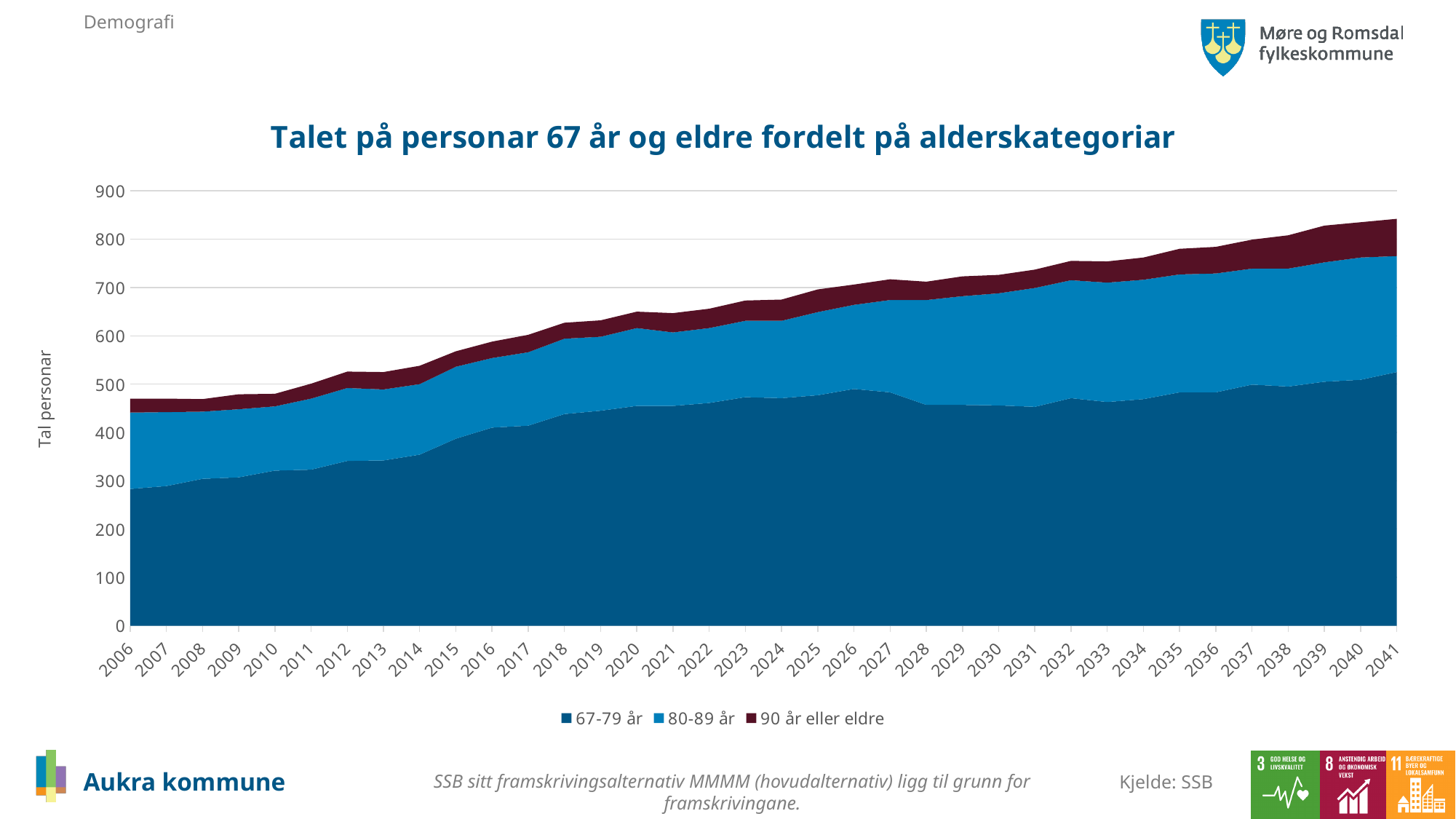
Is the total for 2006 greater or less than 500? less Does the total number of persons 67 years and older rise or fall from 2006 to 2041? Rise Is the total for 2041 greater or less than 800? greater Which is larger, the total for 2006 or the total for 2041? 2041 How many series does the legend list? 3 Is the value for 67-79 år in 2041 greater or less than 500? greater What is the title of the chart? Talet på personar 67 år og eldre fordelt på alderskategoriar What is the label on the y axis? Tal personar How many years are shown along the x axis? 36 What kind of chart is shown on the slide? Stacked area chart Which year has the highest total number of persons 67 years and older? 2041